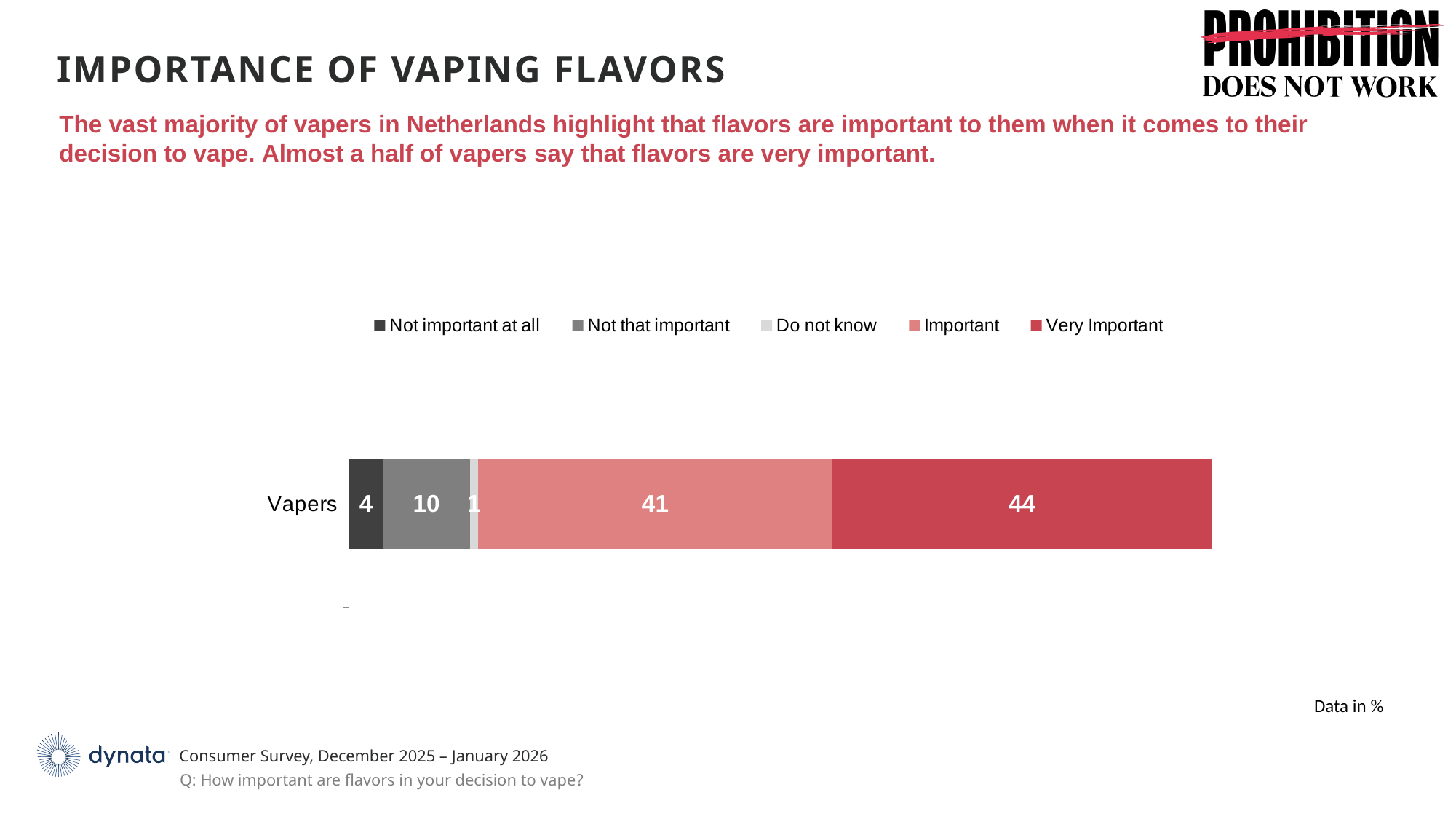
Which response category has the largest share among vapers? Very Important Which response category has the smallest share among vapers? Do not know What percentage of vapers say flavors are Not important at all? 4 What is the total of the Vapers stacked bar? 100 What percentage of vapers answered Do not know? 1 What is the difference between the Very Important and Not that important shares? 34 How many series does the legend list? 5 What percentage of vapers say flavors are Important? 41 What kind of chart is shown on the slide? Stacked bar chart Which is larger for vapers: Important or Not important at all? Important What percentage of vapers say flavors are Not that important? 10 What percentage of vapers say flavors are Very Important? 44